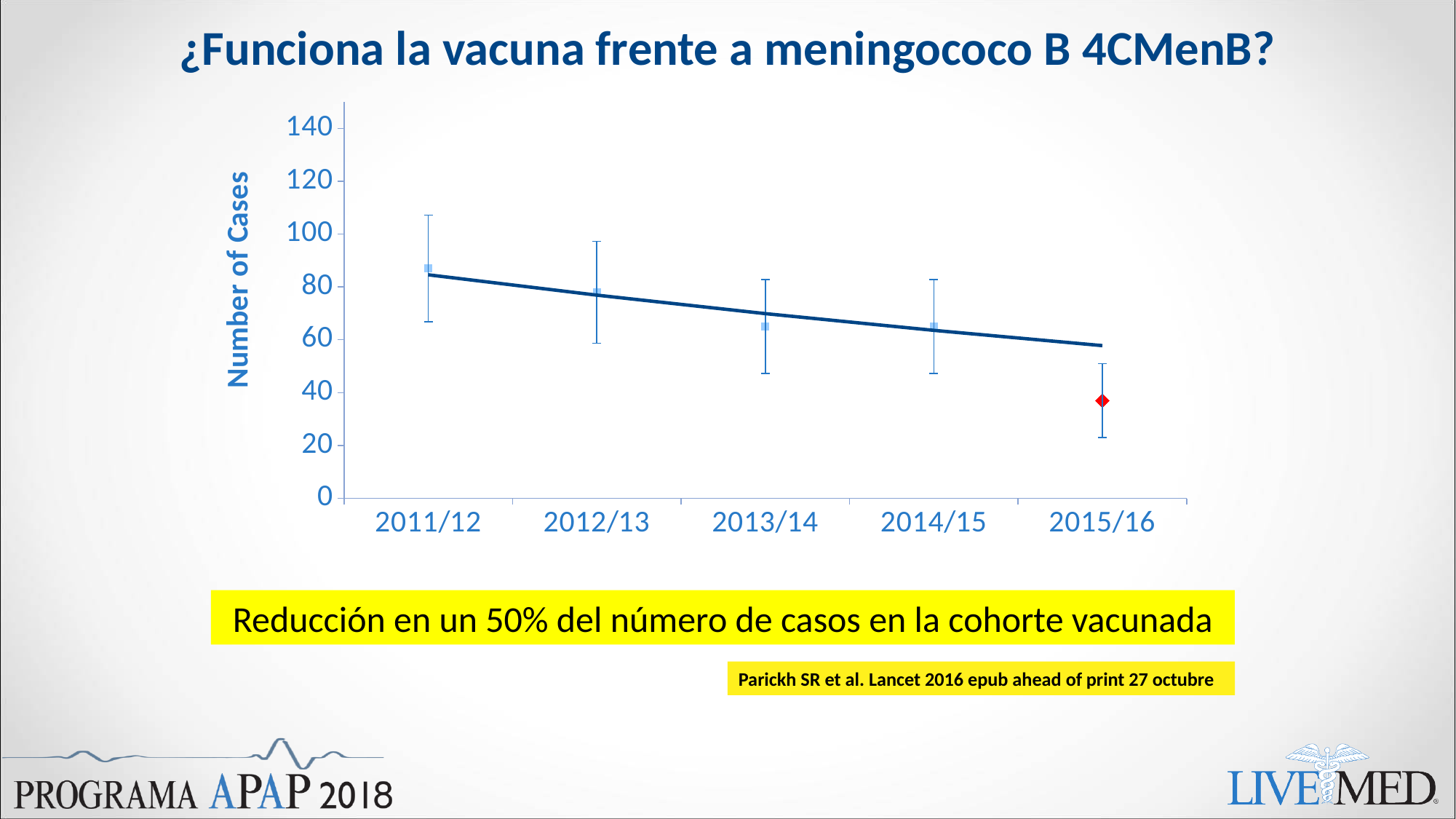
How many time periods are plotted along the x axis? 5 What is the label of the y axis? Number of Cases Which period has the highest number of cases? 2011/12 Which period has the lowest number of cases? 2015/16 Which has more cases, 2011/12 or 2015/16? 2011/12 Is the value for 2011/12 greater or less than 80? greater Do the number of cases rise or fall from 2011/12 to 2015/16? Fall Is the value for 2012/13 greater or less than 60? greater Is the value for 2013/14 greater or less than 80? less What is the highest value shown on the y axis? 140 What kind of chart is shown on the slide? Line chart with error bars